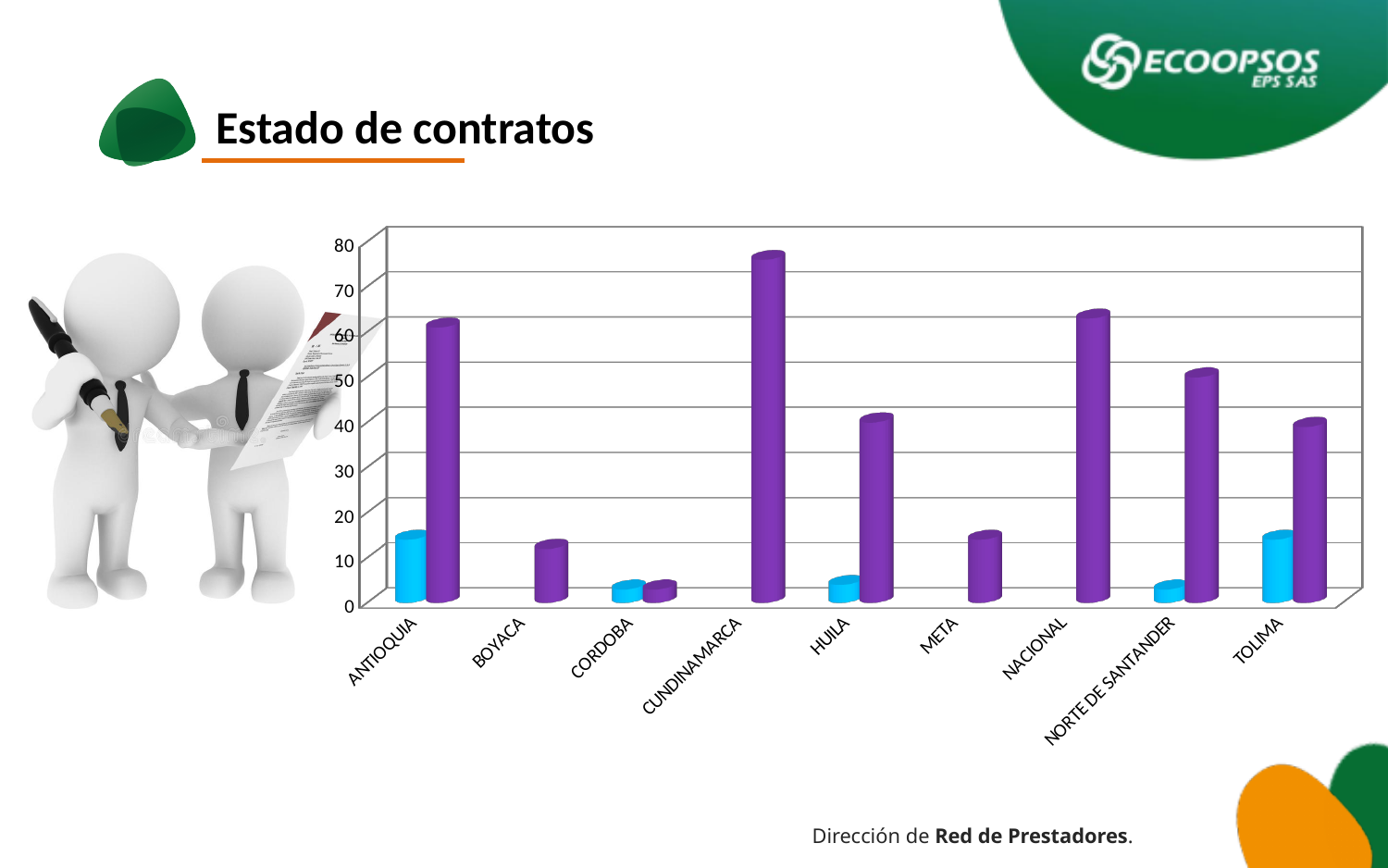
Which has the taller purple bar, ANTIOQUIA or HUILA? ANTIOQUIA Is the purple bar for META greater or less than 20? less Is the purple bar for ANTIOQUIA greater or less than 50? greater Which category has the shortest purple bar? CORDOBA How many categories are shown on the x axis of the chart? 9 What is the title of the slide containing the chart? Estado de contratos Which category has the tallest purple bar? CUNDINAMARCA Is the purple bar for HUILA greater or less than 30? greater What kind of chart is shown on the slide? bar chart Which has the taller purple bar, CUNDINAMARCA or NACIONAL? CUNDINAMARCA